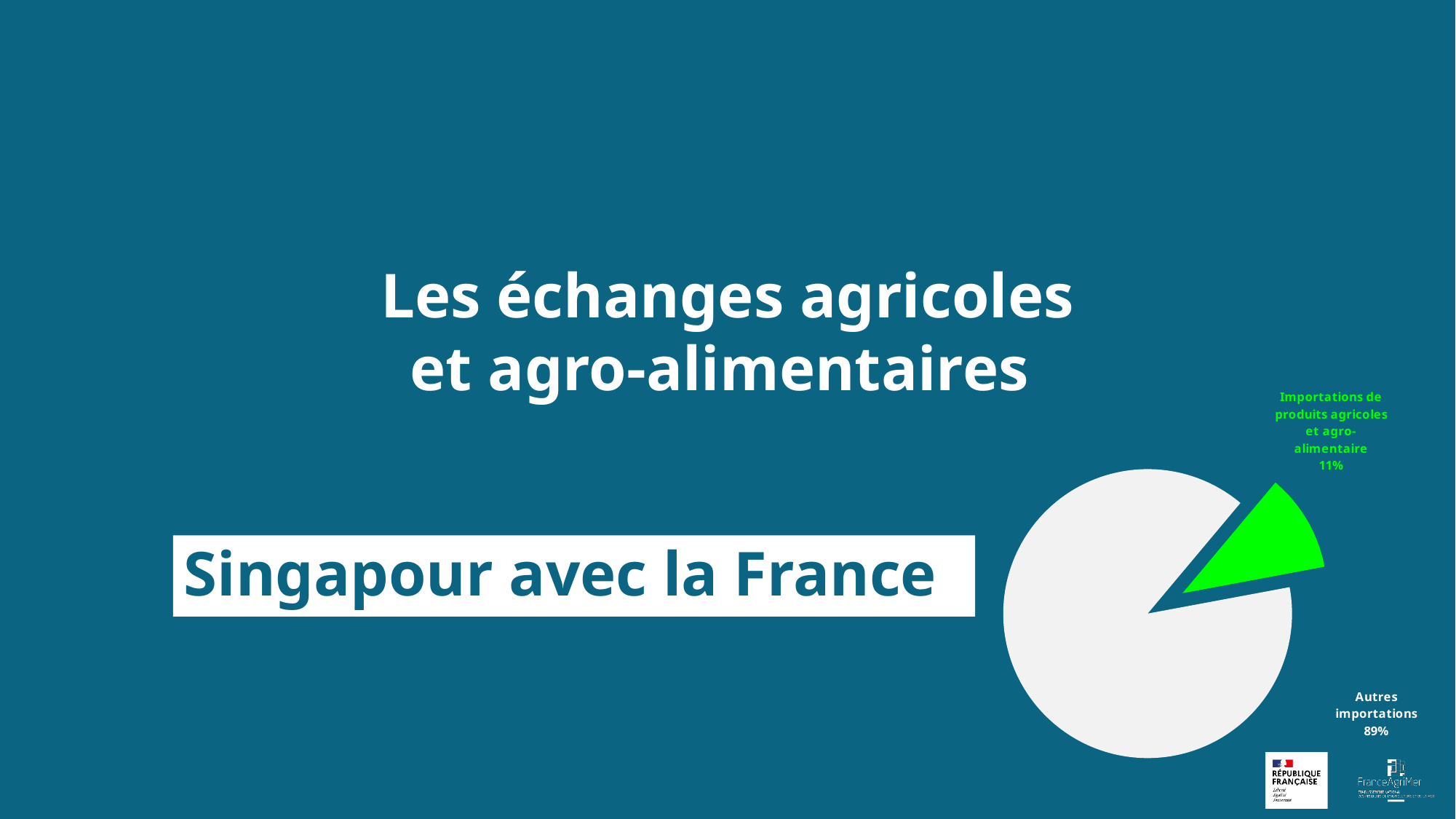
What is the total of the two pie slice percentages? 100% Which slice of the pie is the smallest? Importations de produits agricoles et agro-alimentaire Which is larger: 'Autres importations' or 'Importations de produits agricoles et agro-alimentaire'? Autres importations How many slices does the pie chart have? 2 What kind of chart is shown on the slide? pie chart What share of the pie is 'Autres importations'? 89% What share of the pie is 'Importations de produits agricoles et agro-alimentaire'? 11% What colour is the 'Importations de produits agricoles et agro-alimentaire' slice? green Which slice of the pie is the largest? Autres importations What is the difference in percentage points between 'Autres importations' and 'Importations de produits agricoles et agro-alimentaire'? 78